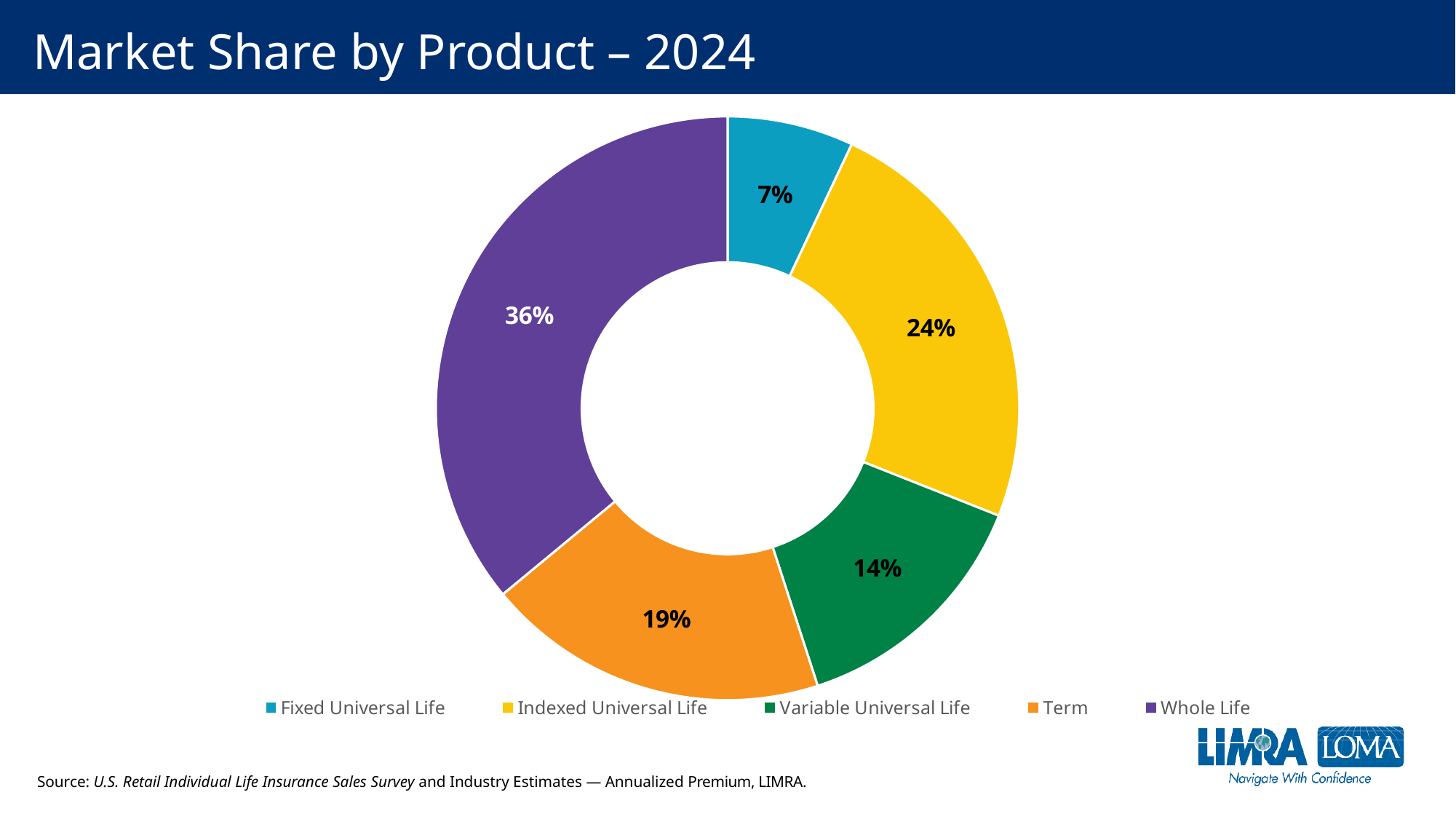
What is the market share for Indexed Universal Life? 24% Which product has the smallest market share? Fixed Universal Life What is the market share for Fixed Universal Life? 7% What is the market share for Variable Universal Life? 14% What is the title of the chart? Market Share by Product – 2024 Which product has the largest market share? Whole Life How many products are shown in the chart? 5 What is the market share for Term? 19% Which has a larger market share, Indexed Universal Life or Variable Universal Life? Indexed Universal Life What is the market share for Whole Life? 36% What kind of chart is shown on the slide? Doughnut chart What is the difference in market share between Whole Life and Term? 17%